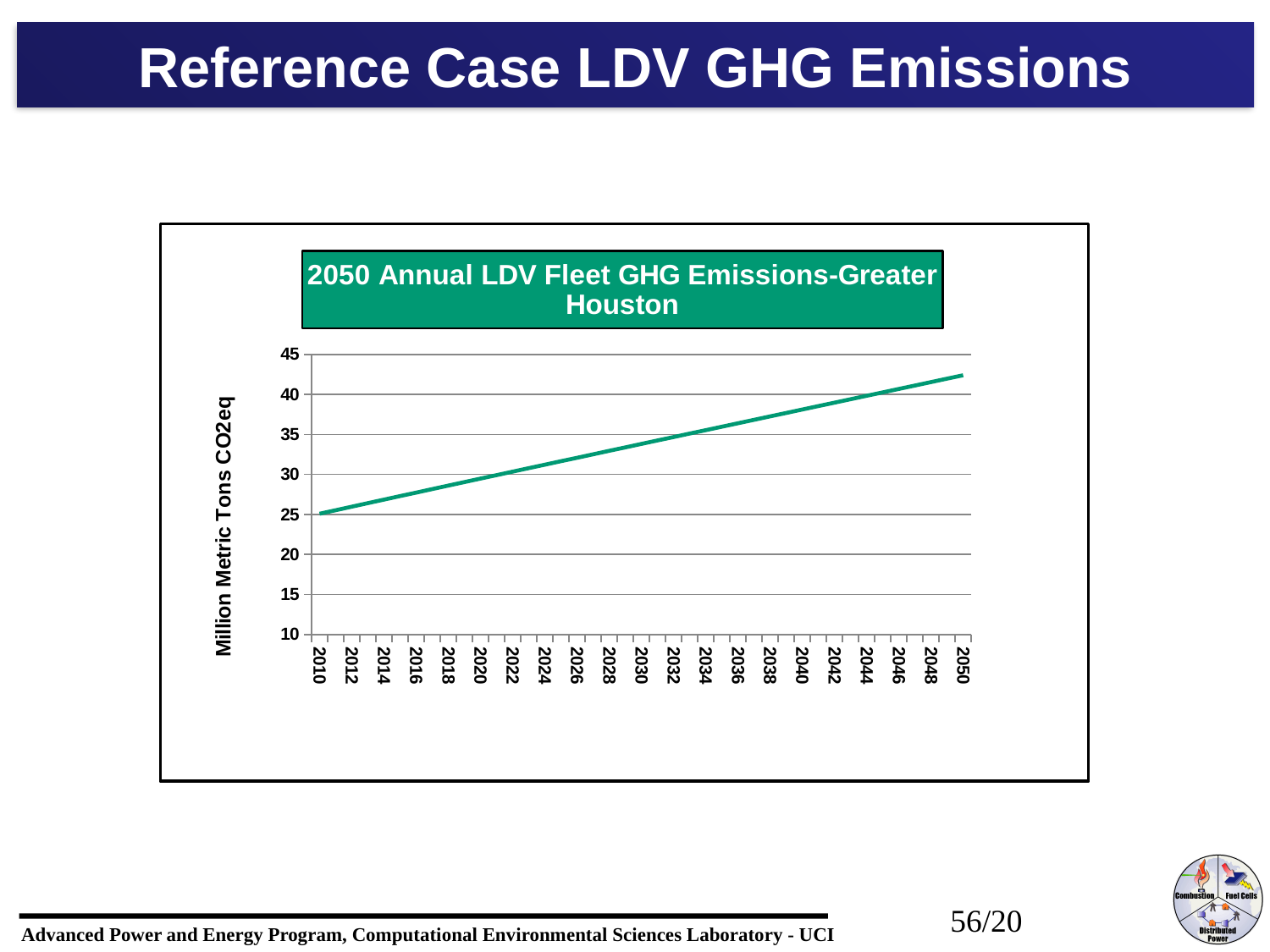
Do the GHG emissions rise or fall from 2010 to 2050? rise How many year labels are shown on the x axis? 21 Is the value for 2010 greater or less than 30? less Is the value for 2050 greater or less than 40? greater Which year has the lowest GHG emissions? 2010 Which year has higher emissions, 2020 or 2040? 2040 What kind of chart is shown on the slide? line chart Which year has the highest GHG emissions? 2050 Is the value for 2030 greater or less than 30? greater What is the label of the y axis? Million Metric Tons CO2eq